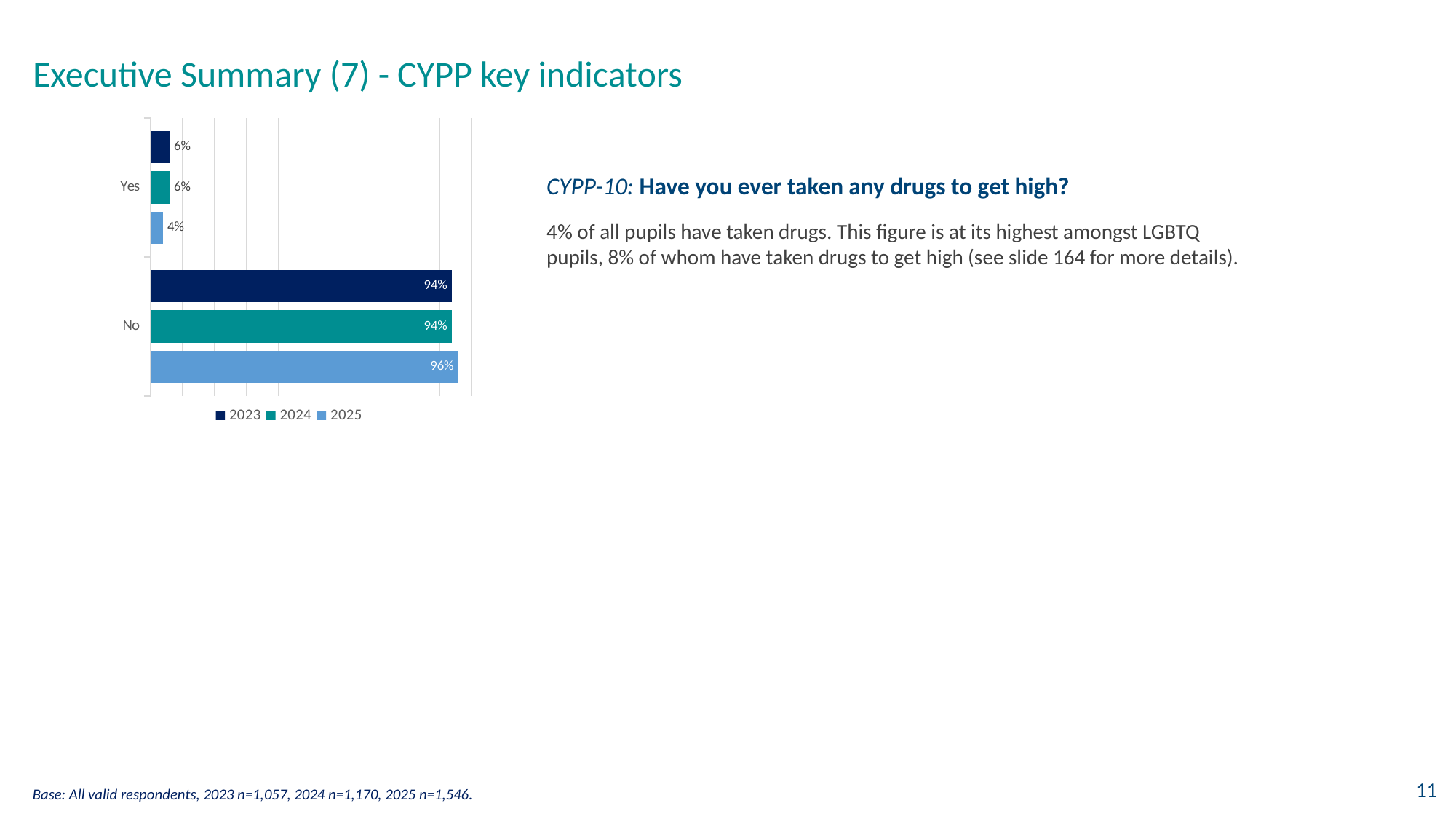
What percentage of pupils answered 'Yes' in 2025? 4% Which year has the lowest 'Yes' value? 2025 What percentage of pupils answered 'No' in 2025? 96% What kind of chart is shown on the slide? Bar chart What percentage of pupils answered 'No' in 2023? 94% Which year has the highest 'No' value? 2025 What percentage of pupils answered 'Yes' in 2023? 6% Which years are listed in the chart legend? 2023, 2024, 2025 What is the difference between the 'No' value in 2025 and the 'No' value in 2024? 2% How many series does the legend list? 3 Is the 'Yes' value for 2024 larger or smaller than the 'Yes' value for 2025? larger How many response categories are shown on the chart? 2